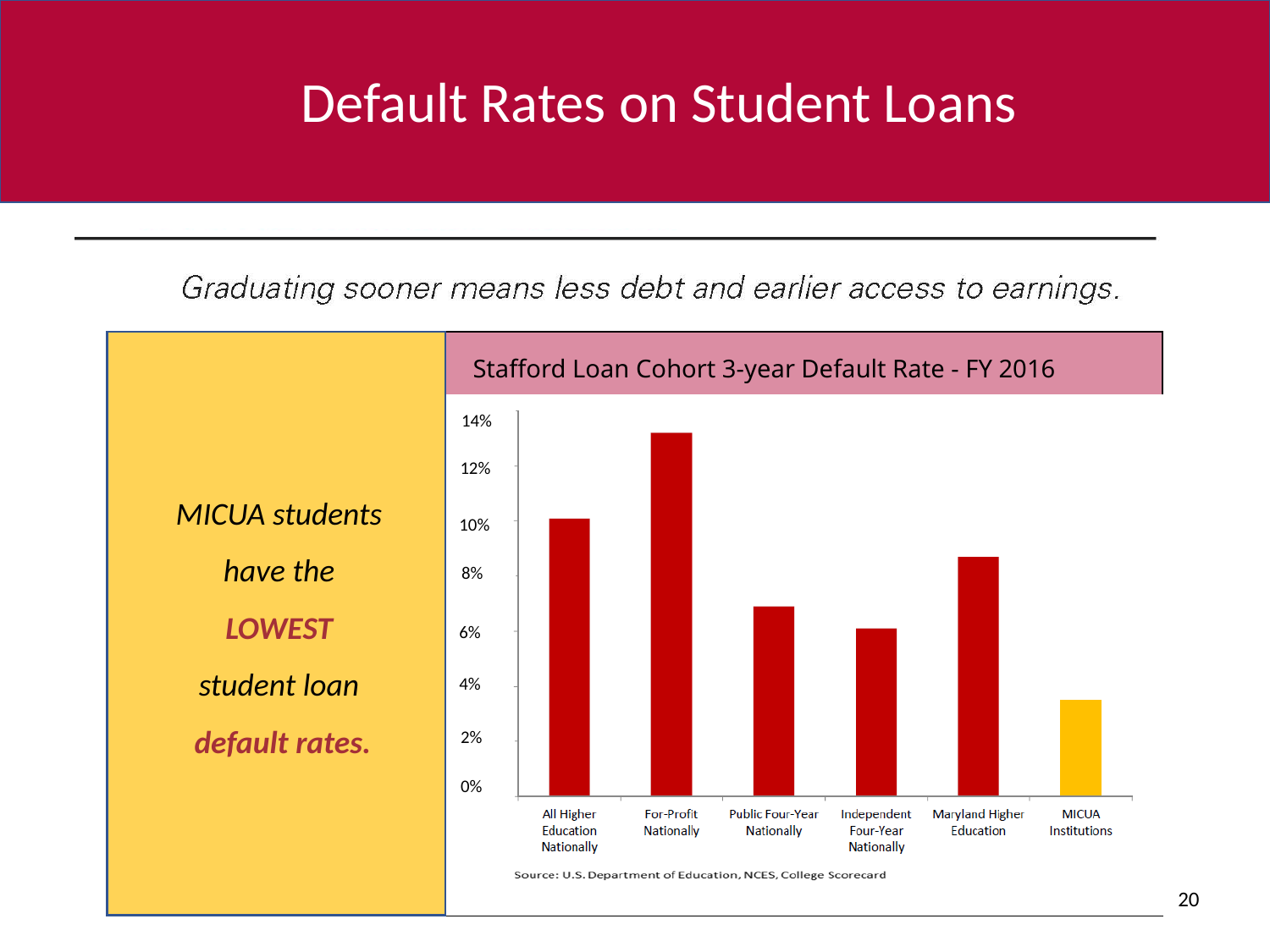
How many categories are plotted in the chart? 6 Which bar is shown in a different colour (yellow) from the others? MICUA Institutions Is the value for For-Profit Nationally greater or less than 12%? greater Is the value for Maryland Higher Education greater or less than 8%? greater What kind of chart is shown on the slide? bar chart Is the value for Independent Four-Year Nationally greater or less than 8%? less Which has a higher default rate, Public Four-Year Nationally or Maryland Higher Education? Maryland Higher Education What is the title of the chart? Stafford Loan Cohort 3-year Default Rate - FY 2016 Which category has the lowest default rate? MICUA Institutions Which category has the highest default rate? For-Profit Nationally